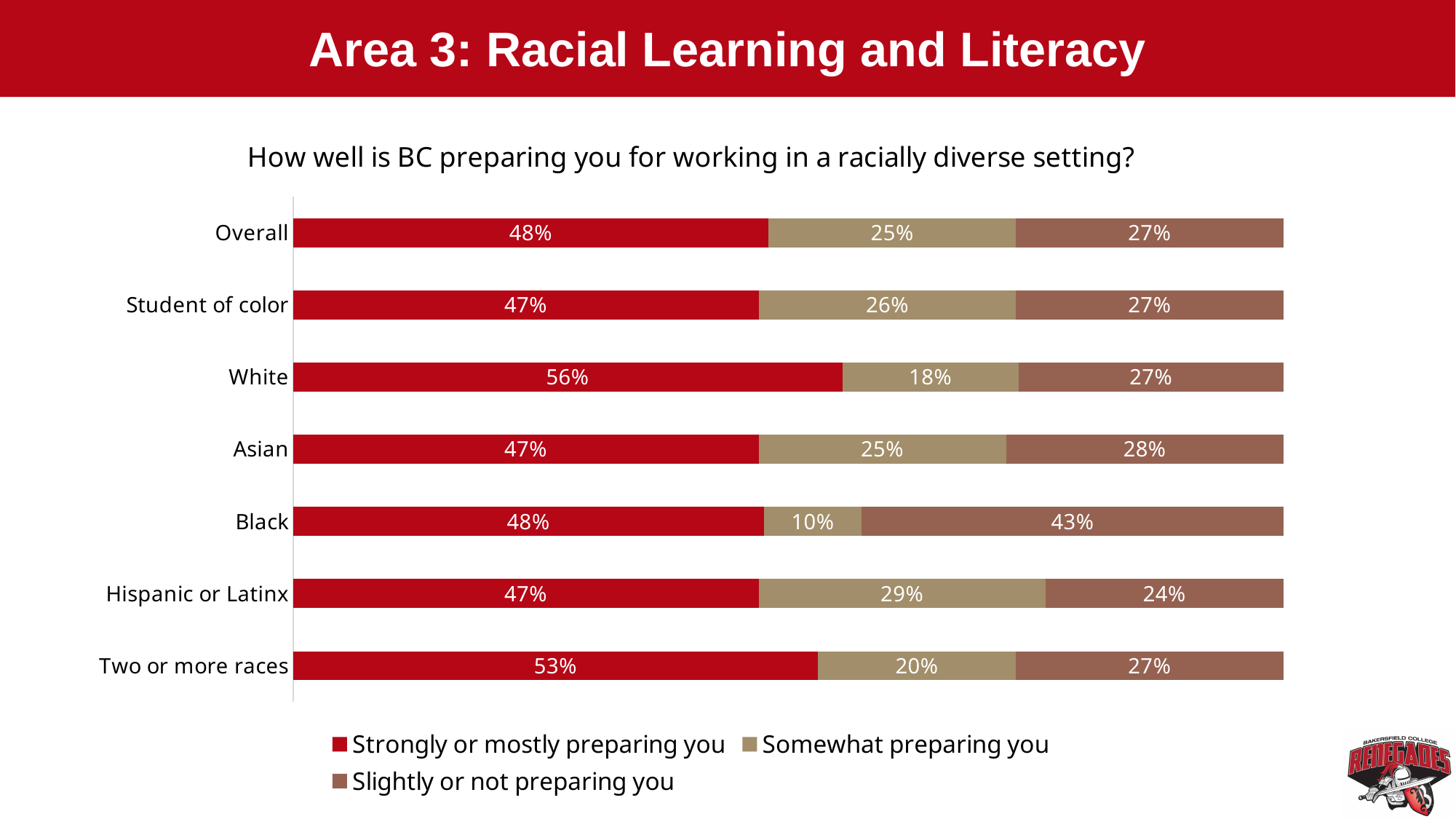
Which has a larger 'Somewhat preparing you' value: Hispanic or Latinx, or Two or more races? Hispanic or Latinx What kind of chart is shown on the slide? Stacked bar chart How many series does the legend list? 3 How many groups are shown on the chart? 7 How many percentage points higher is the 'Strongly or mostly preparing you' value for White students than for Asian students? 9 What is the 'Somewhat preparing you' value for Hispanic or Latinx students? 29% What is the 'Slightly or not preparing you' value for Black students? 43% Which group has the highest 'Slightly or not preparing you' percentage? Black Which group has the lowest 'Somewhat preparing you' percentage? Black What percentage of Overall respondents said BC is strongly or mostly preparing them? 48% Which group has the highest 'Strongly or mostly preparing you' percentage? White What is the difference between the 'Slightly or not preparing you' value for Black students and for Overall? 16